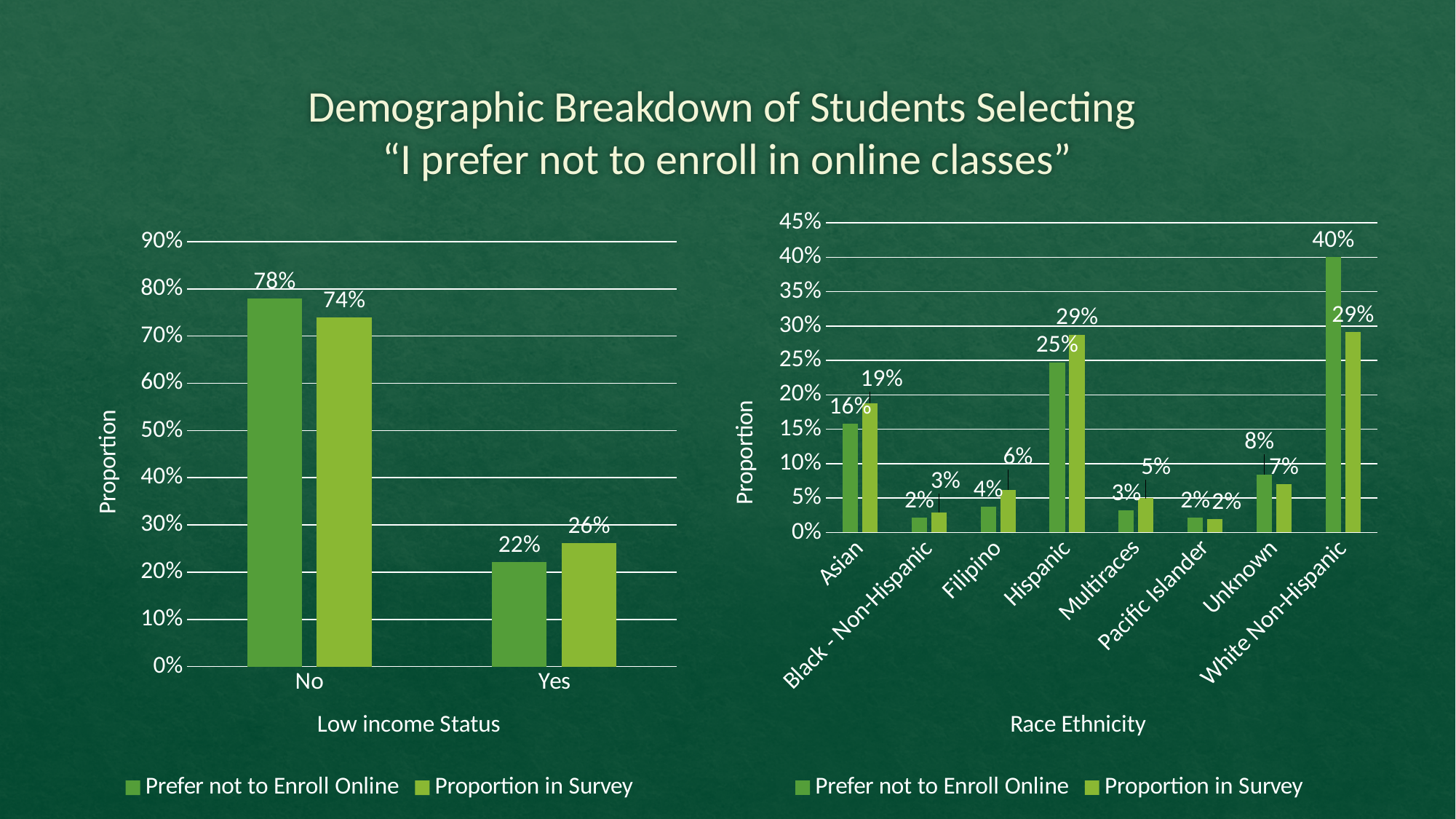
In the Low income Status chart, how many series does the legend list? 2 In the Race Ethnicity chart, what is the value of Proportion in Survey for Filipino? 6% What kind of chart is the Race Ethnicity chart? Bar chart In the Low income Status chart, what is the value of Prefer not to Enroll Online for No? 78% In the Race Ethnicity chart, what is the value of Prefer not to Enroll Online for Hispanic? 25% In the Low income Status chart, what is the difference between Prefer not to Enroll Online and Proportion in Survey for No? 4% In the Race Ethnicity chart, which is larger for Unknown: Prefer not to Enroll Online or Proportion in Survey? Prefer not to Enroll Online In the Race Ethnicity chart, what is the value of Proportion in Survey for White Non-Hispanic? 29% In the Race Ethnicity chart, how many categories are shown on the x axis? 8 In the Race Ethnicity chart, what is the difference between Prefer not to Enroll Online and Proportion in Survey for White Non-Hispanic? 11% In the Race Ethnicity chart, which category has the highest Prefer not to Enroll Online value? White Non-Hispanic In the Low income Status chart, what is the value of Proportion in Survey for Yes? 26%